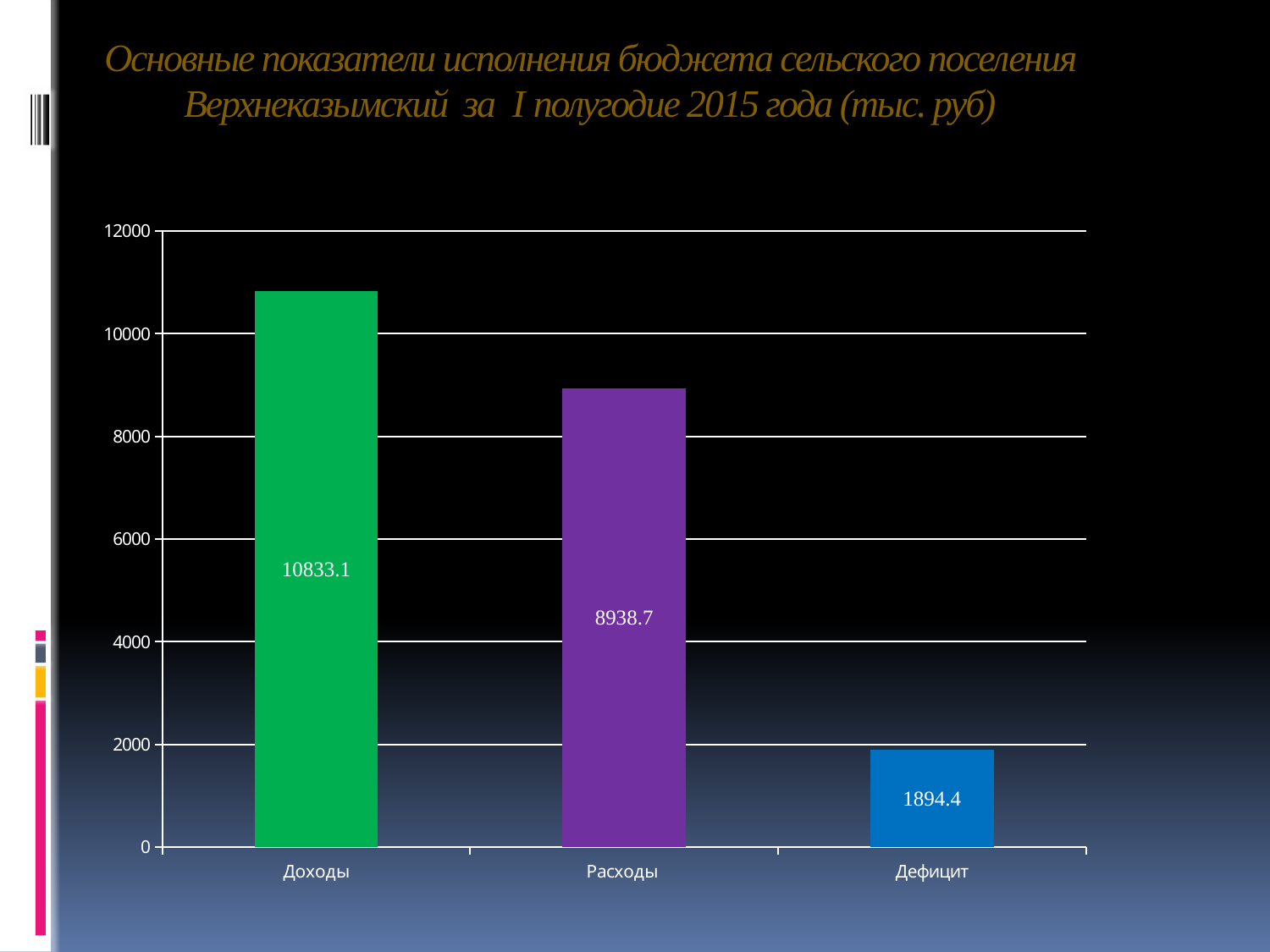
How many categories are shown on the x axis? 3 What kind of chart is shown on the slide? bar chart What colour is the bar for Доходы? green Is the value for Расходы greater or less than 10000? less What is the value for Доходы? 10833.1 Is the value for Дефицит greater or less than 2000? less What is the value for Расходы? 8938.7 What is the value for Дефицит? 1894.4 Which category has the highest value? Доходы Which is larger, the value for Расходы or the value for Дефицит? Расходы Which category has the lowest value? Дефицит What is the difference between the values for Доходы and Расходы? 1894.4